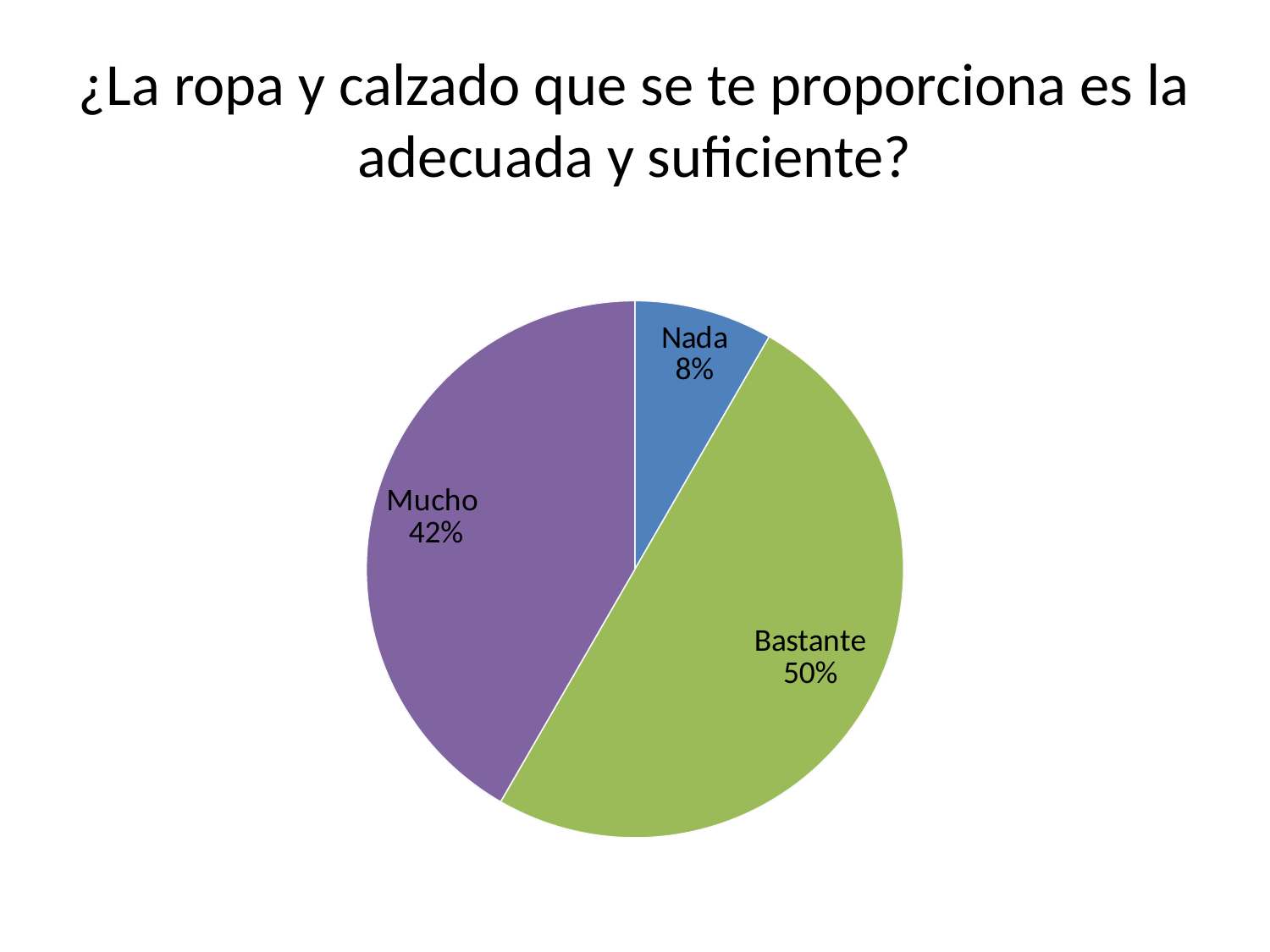
What share of the pie does the Bastante slice represent? 50% What colour is the Bastante slice? green What type of chart is shown on the slide? pie chart What share of the pie does the Mucho slice represent? 42% How many slices does the pie chart have? 3 Which category has the smallest slice of the pie? Nada What is the difference in percentage points between the Mucho and Nada slices? 34 Which category has the largest slice of the pie? Bastante What share of the pie does the Nada slice represent? 8% What is the difference in percentage points between the Bastante and Mucho slices? 8 What is the title of the chart on the slide? ¿La ropa y calzado que se te proporciona es la adecuada y suficiente? Which slice is larger, Mucho or Nada? Mucho